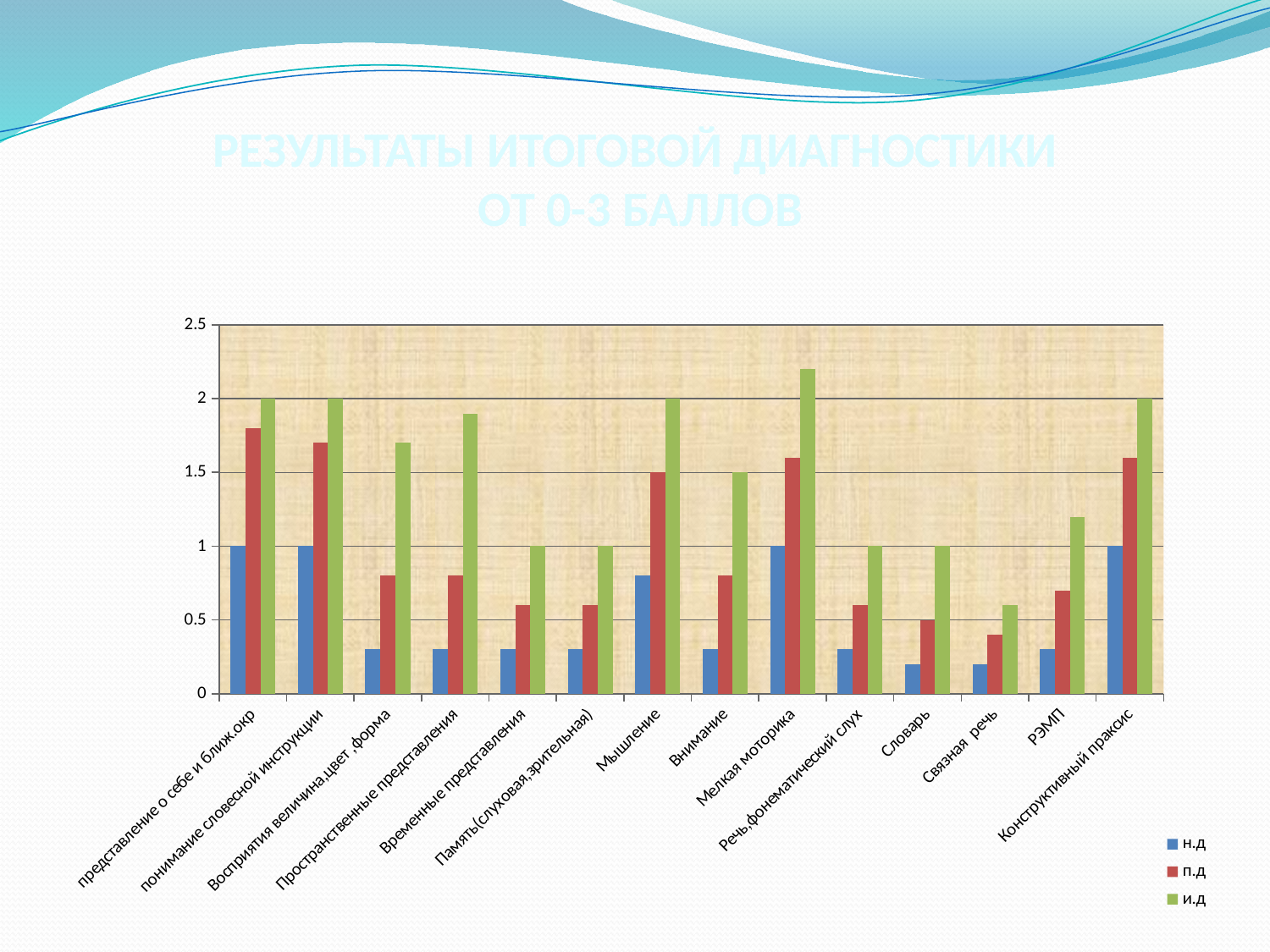
What is the value of п.д for Мышление? 1.5 What is the value of н.д for Мелкая моторика? 1 How many series does the legend list? 3 Is the value of п.д for Словарь greater or less than 1? less How many categories are shown along the x axis? 14 What is the value of и.д for Мышление? 2 Is the value of и.д for Пространственные представления greater or less than 1.5? greater Which category has the highest и.д value? Мелкая моторика What is the difference between и.д and н.д for Конструктивный праксис? 1 Which category has the lowest и.д value? Связная речь Which is larger: п.д for представление о себе и ближ.окр or п.д for Восприятия величины,цвет, форма? п.д for представление о себе и ближ.окр What kind of chart is shown on the slide? bar chart